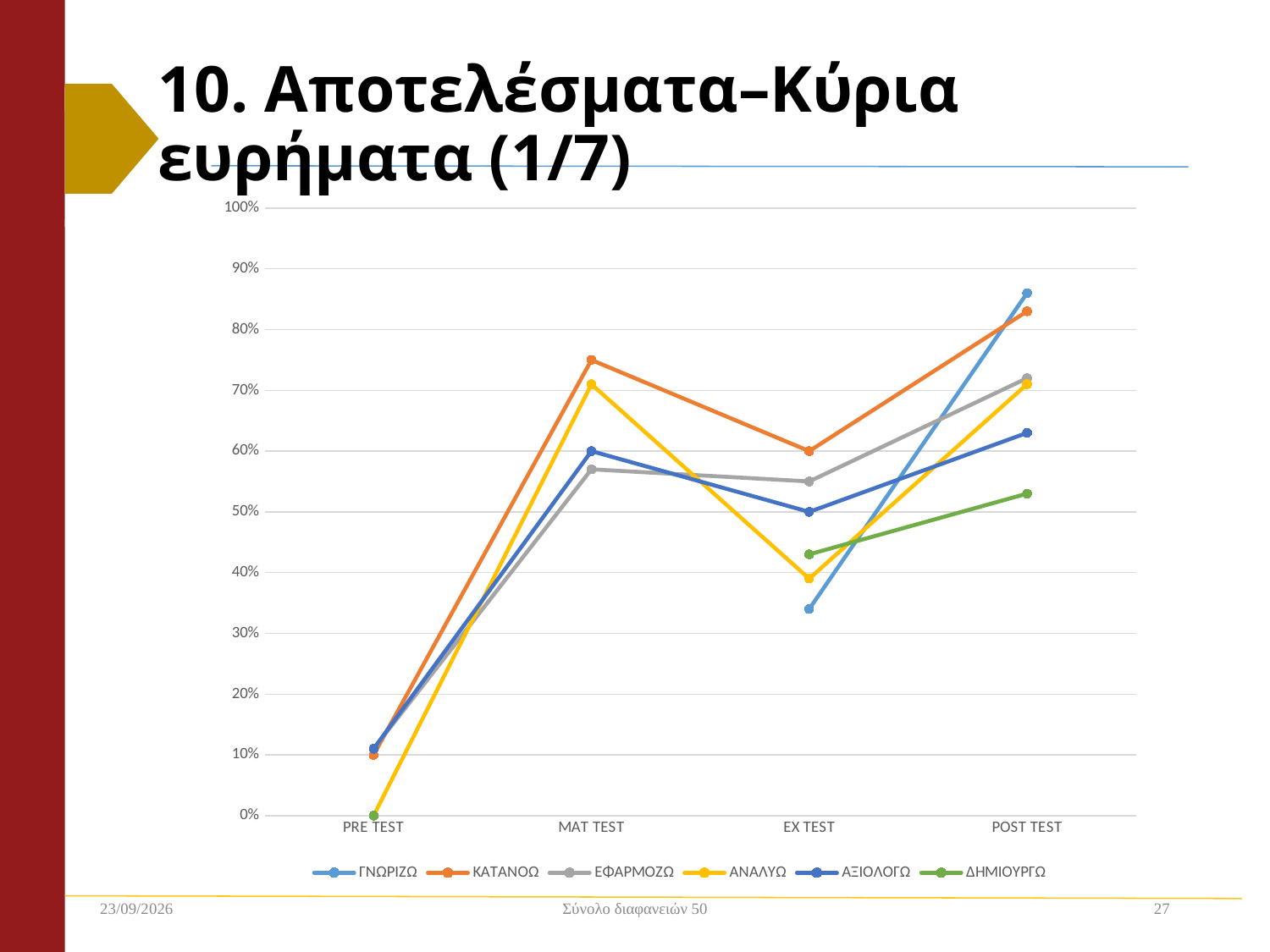
How many categories are shown on the x axis? 4 Which series is listed first in the legend? ΓΝΩΡΙΖΩ Is the value for ΔΗΜΙΟΥΡΓΩ at POST TEST greater or less than 50%? greater At EX TEST, which is larger: ΕΦΑΡΜΟΖΩ or ΑΝΑΛΥΩ? ΕΦΑΡΜΟΖΩ Which series has the lowest value at EX TEST? ΓΝΩΡΙΖΩ Is the value for ΚΑΤΑΝΟΩ at POST TEST greater or less than 80%? greater Which series has the highest value at MAT TEST? ΚΑΤΑΝΟΩ Is the value for ΓΝΩΡΙΖΩ at EX TEST greater or less than 40%? less What kind of chart is shown on the slide? line chart How many series does the legend list? 6 Does the value for ΚΑΤΑΝΟΩ rise or fall from PRE TEST to MAT TEST? rise Which series has the highest value at POST TEST? ΓΝΩΡΙΖΩ